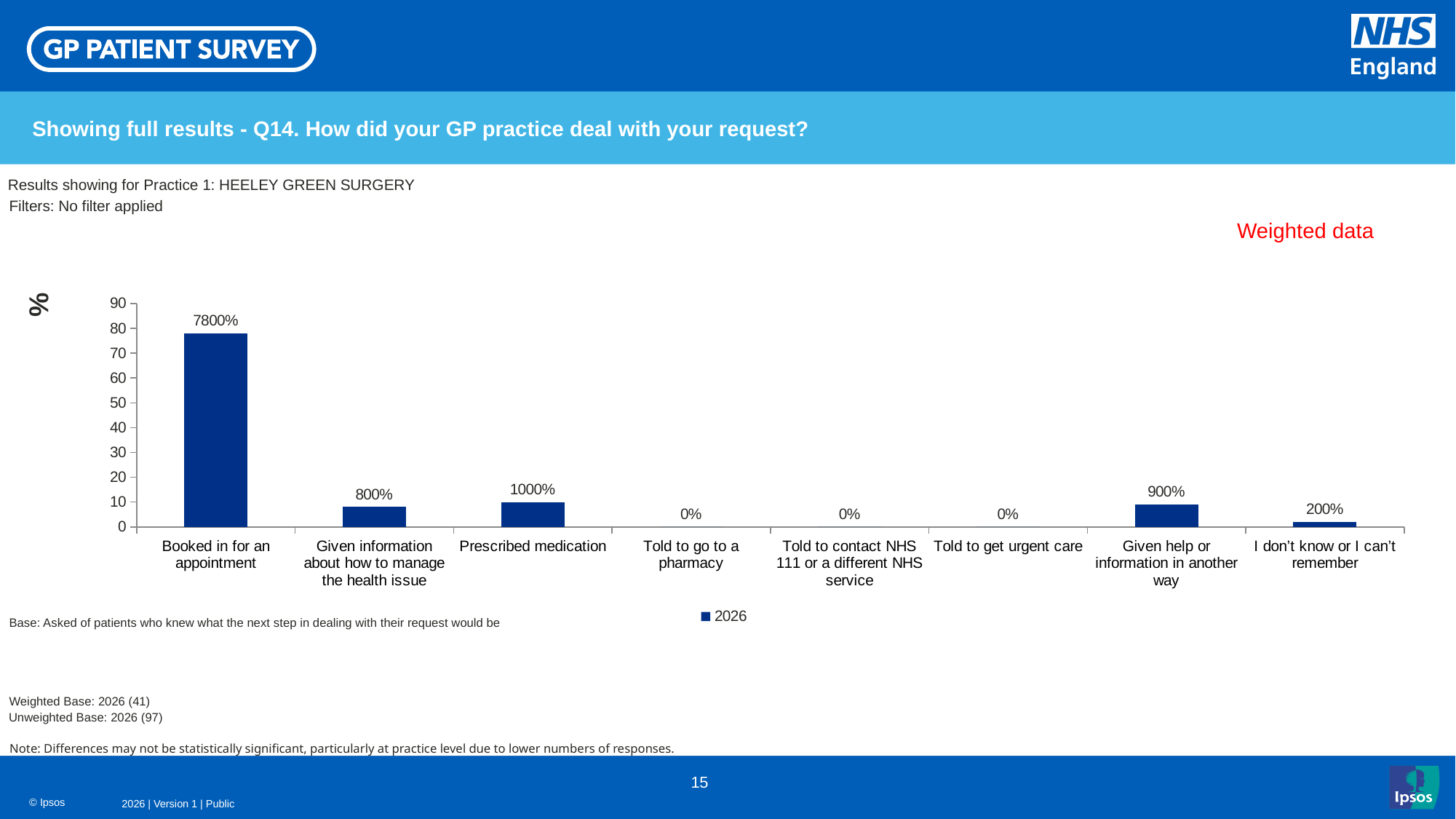
Is the bar for 'Booked in for an appointment' greater or less than 70 on the axis? greater Which category has the highest value? Booked in for an appointment Which is larger, the value for 'Prescribed medication' or the value for 'Given information about how to manage the health issue'? Prescribed medication How many series does the legend list? 1 What is the data label shown for 'Prescribed medication'? 1000% What series name is shown in the legend? 2026 What kind of chart is shown? Bar chart What is the data label shown for 'I don't know or I can't remember'? 200% How many categories are shown on the x axis? 8 Is the bar for 'Given help or information in another way' greater or less than 20 on the axis? less What is the data label shown for 'Given help or information in another way'? 900% What is the data label shown for 'Booked in for an appointment'? 7800%